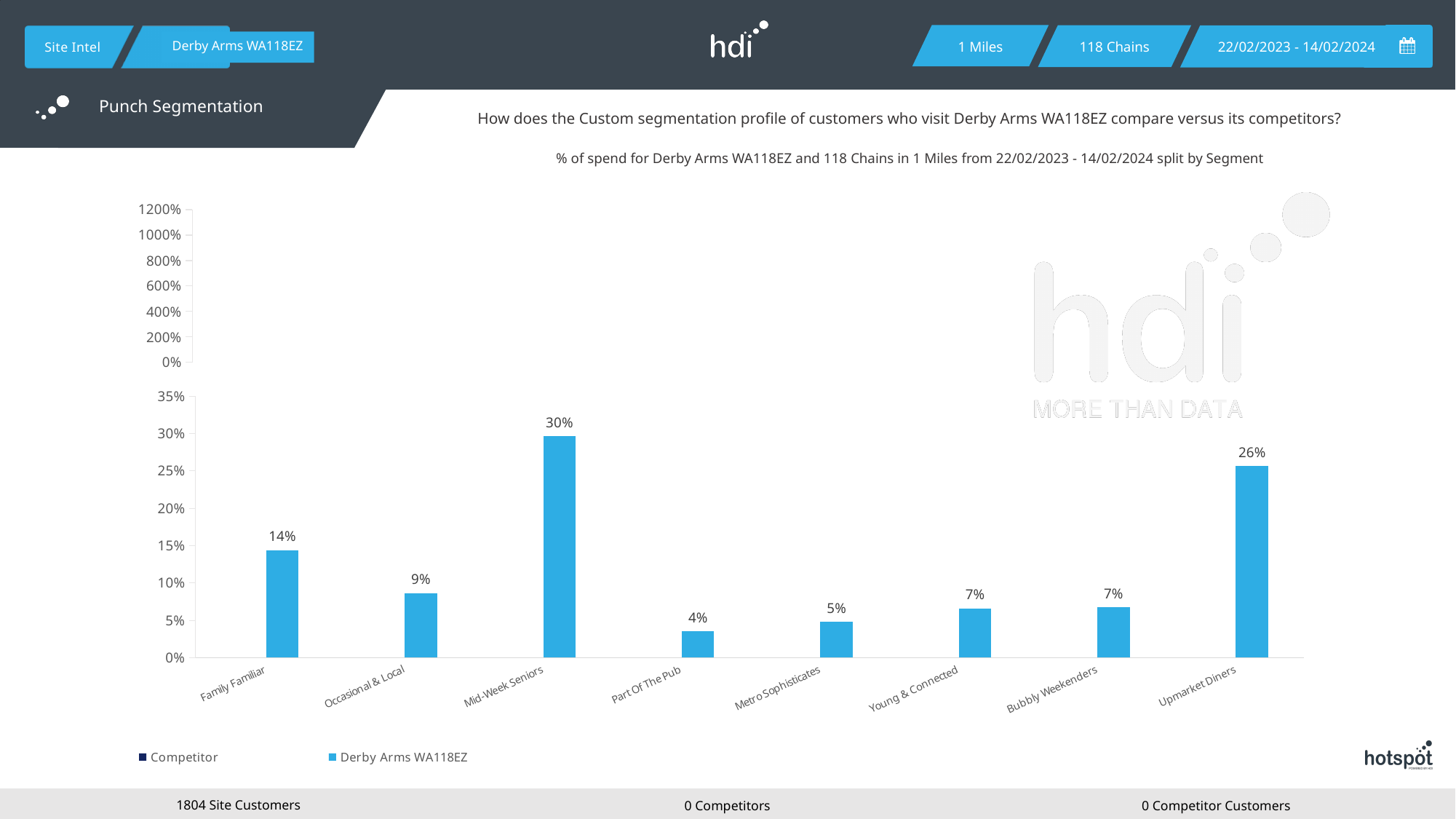
Is the value for Upmarket Diners greater or less than 20%? greater How many series does the legend list? 2 What is the value for Mid-Week Seniors? 30% What is the value for Upmarket Diners? 26% What is the difference between the values for Mid-Week Seniors and Upmarket Diners? 4% What kind of chart is shown on the slide? bar chart What are the two series named in the legend? Competitor and Derby Arms WA118EZ Which is larger, the value for Family Familiar or the value for Occasional & Local? Family Familiar Which segment has the highest value? Mid-Week Seniors Which segment has the lowest value? Part Of The Pub What is the value for Part Of The Pub? 4% How many segments are shown on the x axis of the chart? 8